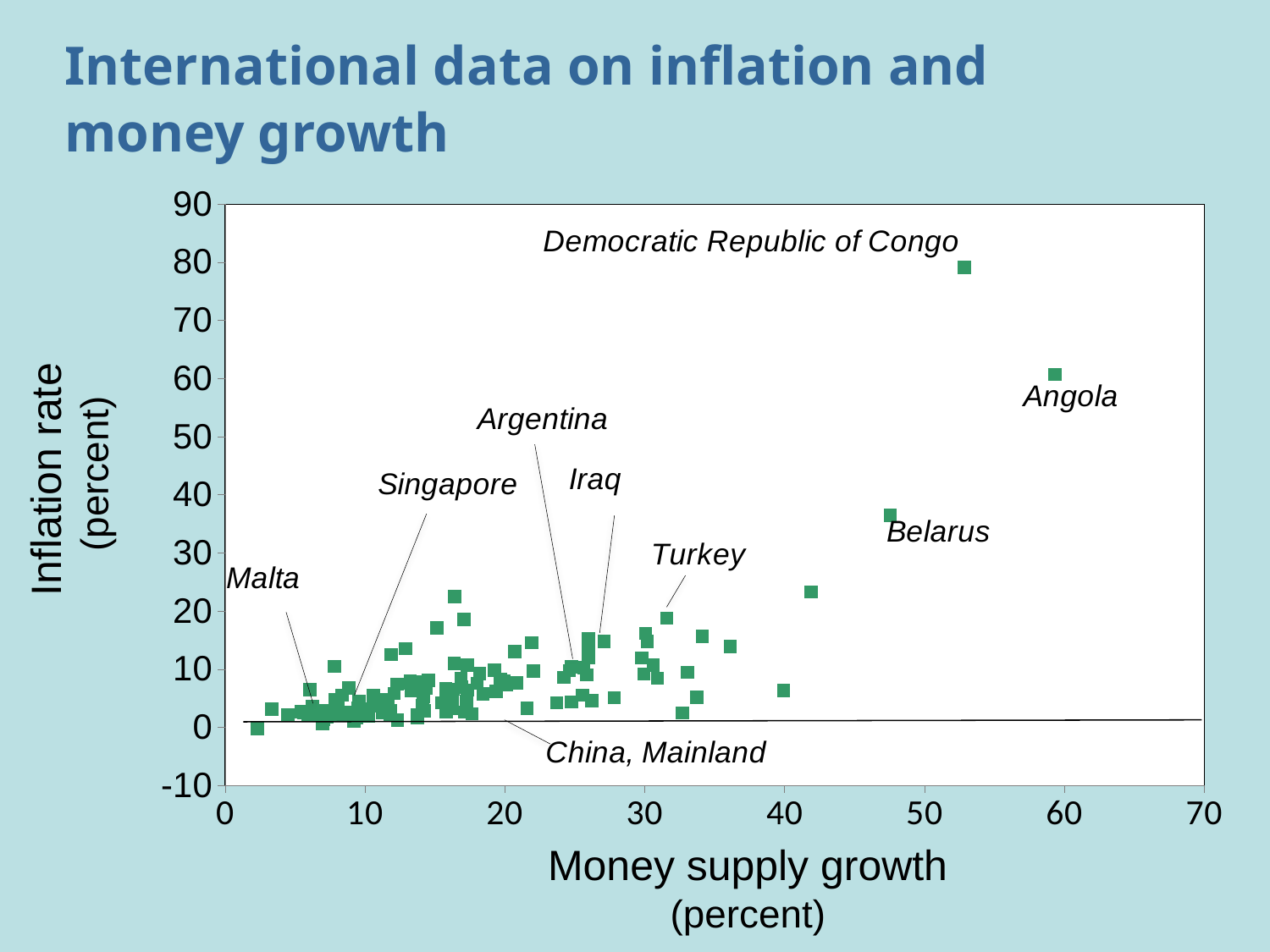
Do inflation rates generally rise or fall as money supply growth increases? rise What variable is plotted on the horizontal axis? Money supply growth (percent) Is the money supply growth for Angola greater or less than 50? greater What is the title of the chart on the slide? International data on inflation and money growth Which has the higher inflation rate, Belarus or Turkey? Belarus Is the inflation rate for Malta greater or less than 10? less Is the inflation rate for the Democratic Republic of Congo greater or less than 70? greater Which labeled country has the highest inflation rate? Democratic Republic of Congo What kind of chart is shown on the slide? scatter plot Which labeled country has the highest money supply growth? Angola